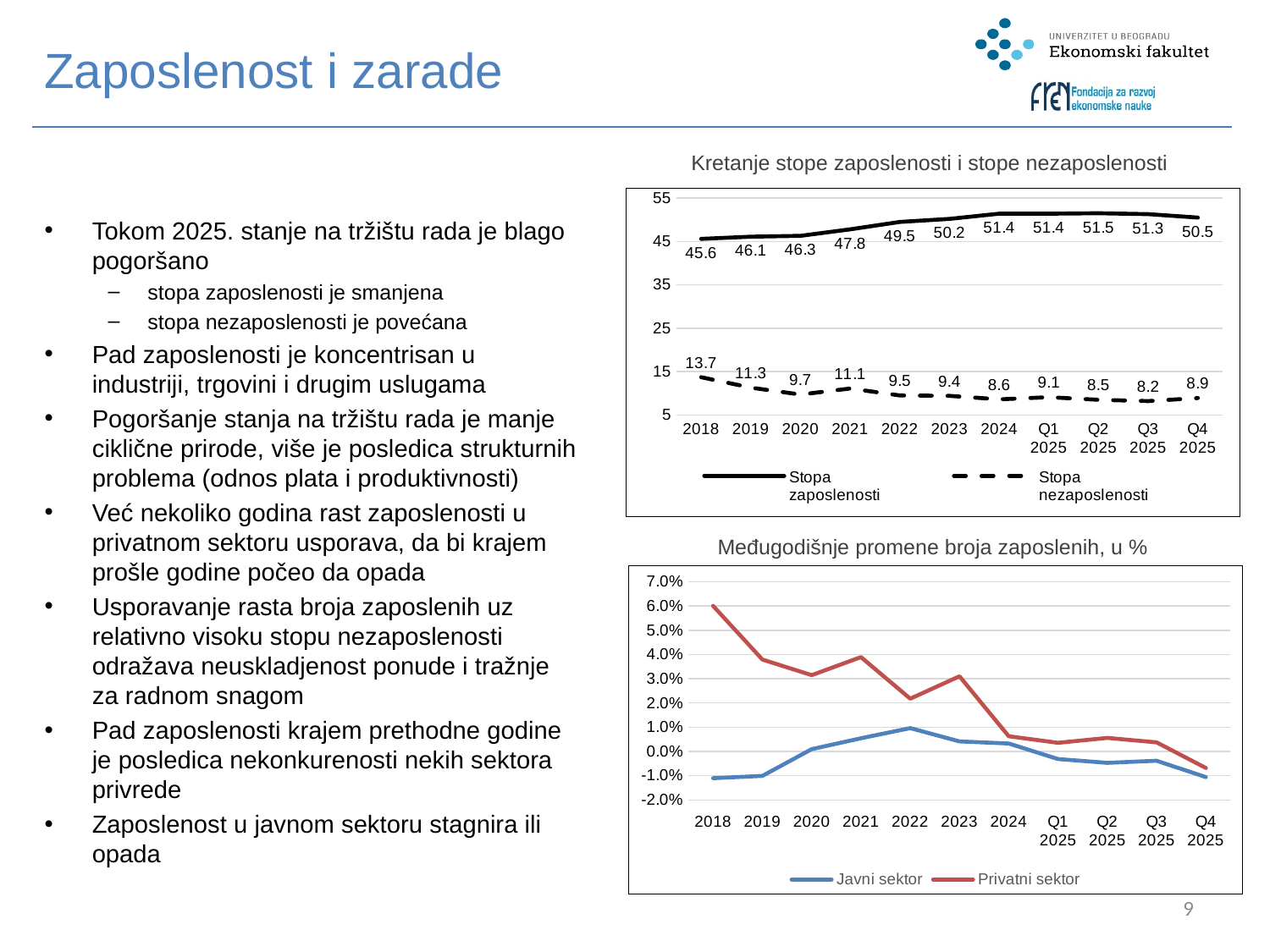
In the chart 'Kretanje stope zaposlenosti i stope nezaposlenosti', what is the value of Stopa zaposlenosti in 2018? 45.6 In the chart 'Međugodišnje promene broja zaposlenih, u %', is the value for Privatni sektor in 2018 greater or less than 5.0%? greater In the chart 'Međugodišnje promene broja zaposlenih, u %', which colour is the Privatni sektor line? red In the chart 'Kretanje stope zaposlenosti i stope nezaposlenosti', in which period is Stopa nezaposlenosti lowest? Q3 2025 In the chart 'Kretanje stope zaposlenosti i stope nezaposlenosti', what is the difference between Stopa zaposlenosti in 2024 and in 2018? 5.8 In the chart 'Međugodišnje promene broja zaposlenih, u %', is the value for Javni sektor in 2018 greater or less than 0.0%? less What kind of chart is 'Međugodišnje promene broja zaposlenih, u %'? line chart In the chart 'Kretanje stope zaposlenosti i stope nezaposlenosti', is Stopa nezaposlenosti higher in 2021 or in 2022? 2021 In the chart 'Kretanje stope zaposlenosti i stope nezaposlenosti', how many series does the legend list? 2 In the chart 'Kretanje stope zaposlenosti i stope nezaposlenosti', how many periods are shown on the x axis? 11 In the chart 'Kretanje stope zaposlenosti i stope nezaposlenosti', in which period is Stopa nezaposlenosti highest? 2018 In the chart 'Kretanje stope zaposlenosti i stope nezaposlenosti', what is the value of Stopa nezaposlenosti in Q4 2025? 8.9